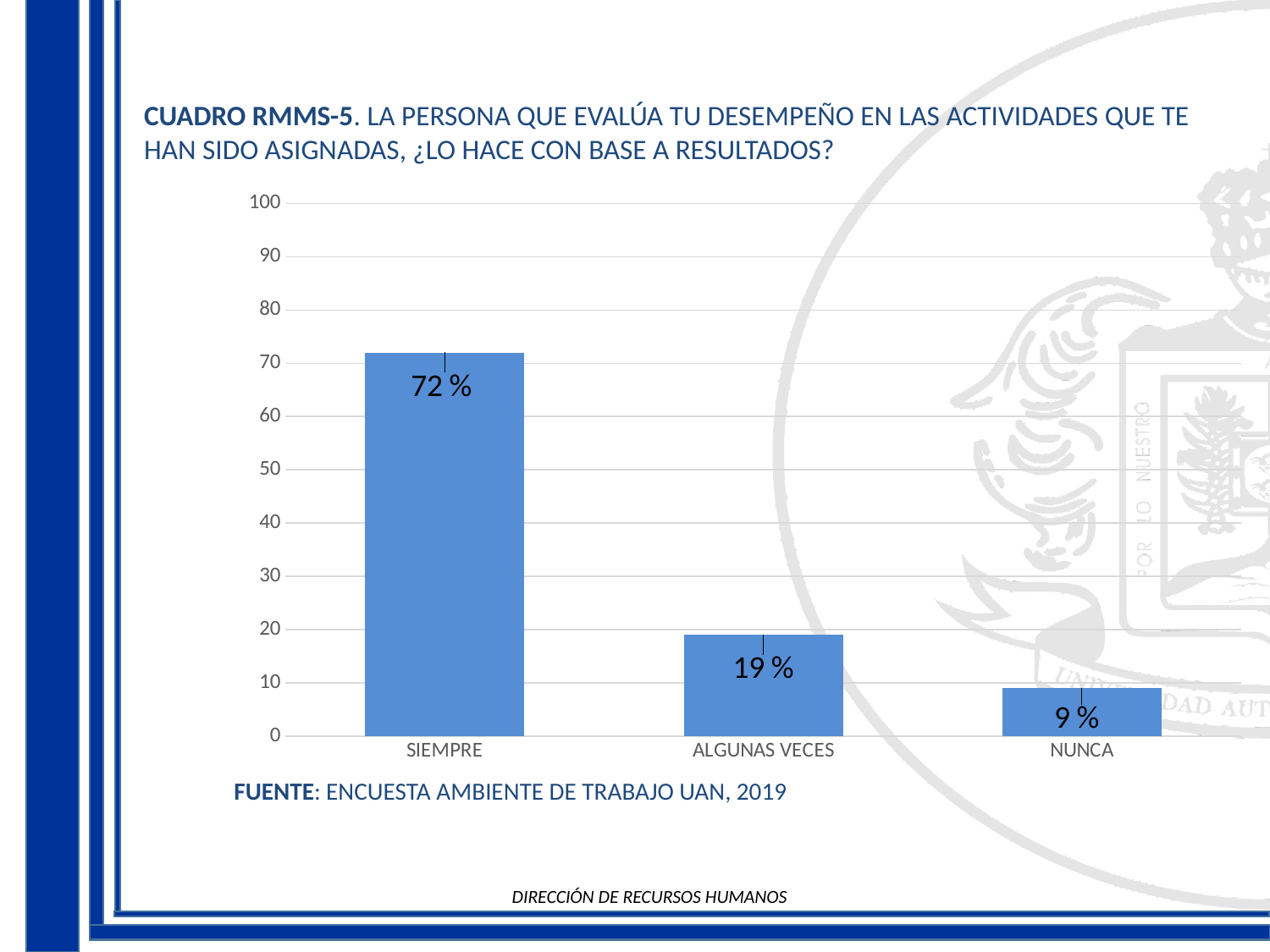
How many categories are shown on the x axis? 3 Which category has the highest value? SIEMPRE Which is larger, the value for ALGUNAS VECES or the value for NUNCA? ALGUNAS VECES What is the value for NUNCA? 9 % Do the values rise or fall from left to right along the x axis? fall Is the value for SIEMPRE greater or less than 60? greater What is the difference between the values for ALGUNAS VECES and NUNCA? 10 % What is the difference between the values for SIEMPRE and ALGUNAS VECES? 53 % What is the value for SIEMPRE? 72 % Which category has the lowest value? NUNCA What kind of chart is shown on the slide? bar chart What is the value for ALGUNAS VECES? 19 %